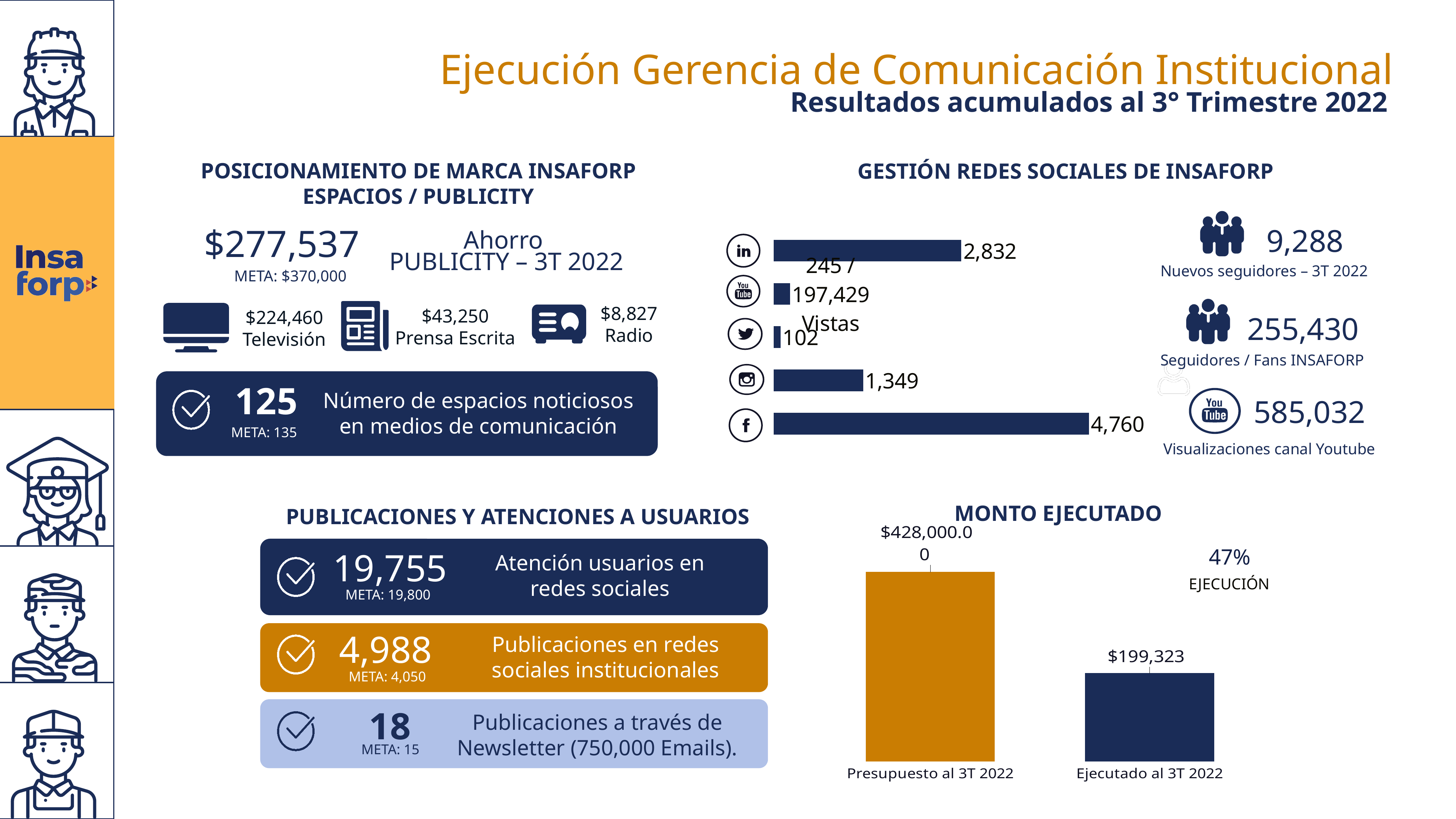
In the GESTIÓN REDES SOCIALES DE INSAFORP chart, what is the difference between the Facebook and LinkedIn values? 1,928 In the GESTIÓN REDES SOCIALES DE INSAFORP chart, what is the value for the Instagram bar? 1,349 In the MONTO EJECUTADO chart, what is the value for Presupuesto al 3T 2022? $428,000.00 In the MONTO EJECUTADO chart, what is the difference between Presupuesto al 3T 2022 and Ejecutado al 3T 2022? $228,677 In the MONTO EJECUTADO chart, which bar is taller, Presupuesto al 3T 2022 or Ejecutado al 3T 2022? Presupuesto al 3T 2022 In the GESTIÓN REDES SOCIALES DE INSAFORP chart, what is the value for the LinkedIn bar? 2,832 In the GESTIÓN REDES SOCIALES DE INSAFORP chart, which platform has the longest bar? Facebook In the MONTO EJECUTADO chart, how many bars are plotted? 2 What kind of chart is the MONTO EJECUTADO chart? Bar chart In the GESTIÓN REDES SOCIALES DE INSAFORP chart, what is the value for the Facebook bar? 4,760 In the MONTO EJECUTADO chart, what colour is the Presupuesto al 3T 2022 bar? Orange In the MONTO EJECUTADO chart, what is the value for Ejecutado al 3T 2022? $199,323